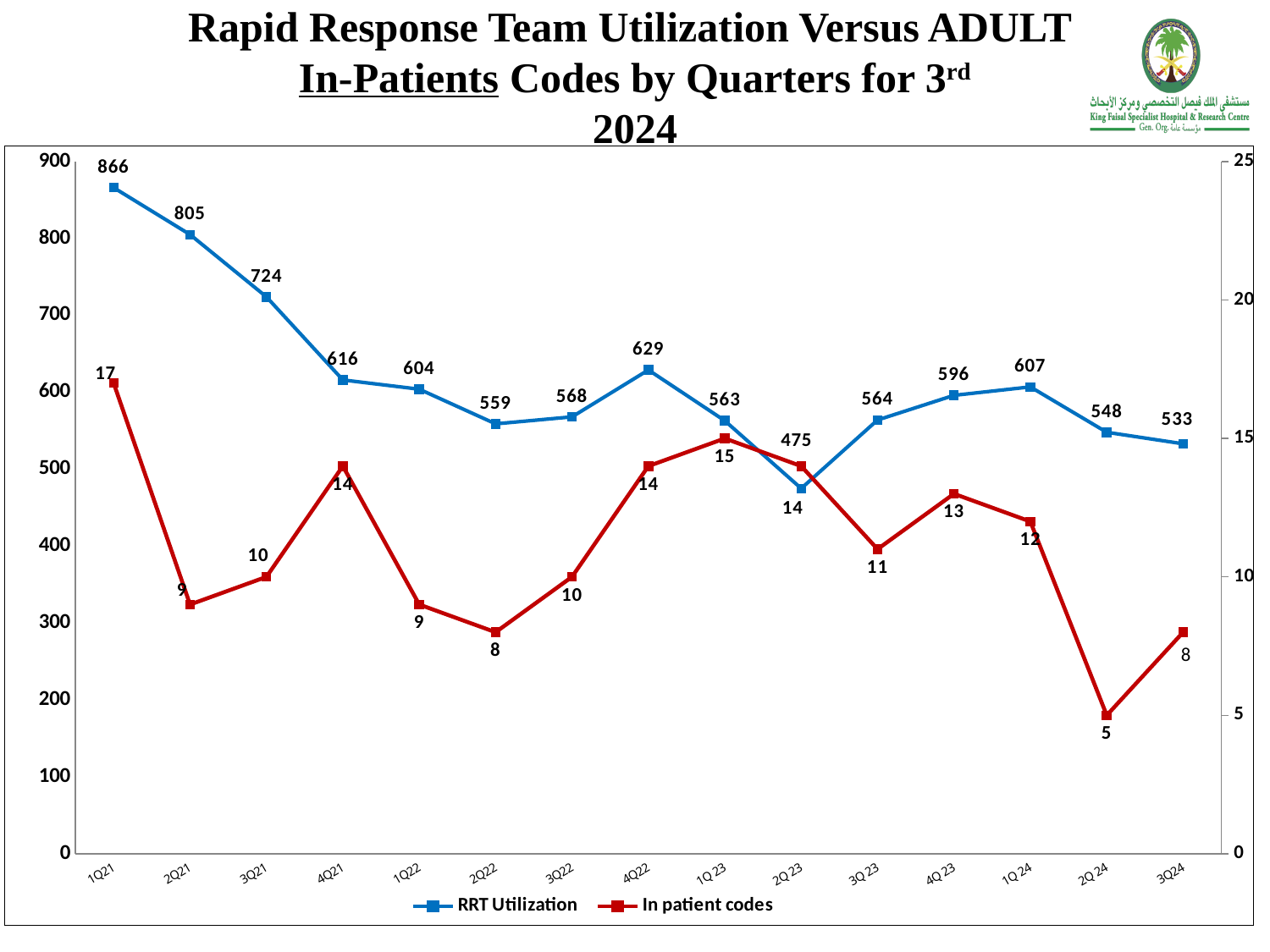
In which quarter is RRT Utilization highest? 1Q21 What kind of chart is shown on the slide? Line chart In which quarter is RRT Utilization lowest? 2Q 23 Which quarter has the higher RRT Utilization, 4Q22 or 1Q 23? 4Q22 How many series does the legend list? 2 What is the difference between RRT Utilization in 1Q21 and in 3Q24? 333 In which quarter are In patient codes highest? 1Q21 What is the In patient codes value for 2Q 24? 5 In which quarter are In patient codes lowest? 2Q 24 What is the RRT Utilization value for 1Q21? 866 What is the In patient codes value for 1Q 23? 15 How many quarters are plotted on the x axis? 15